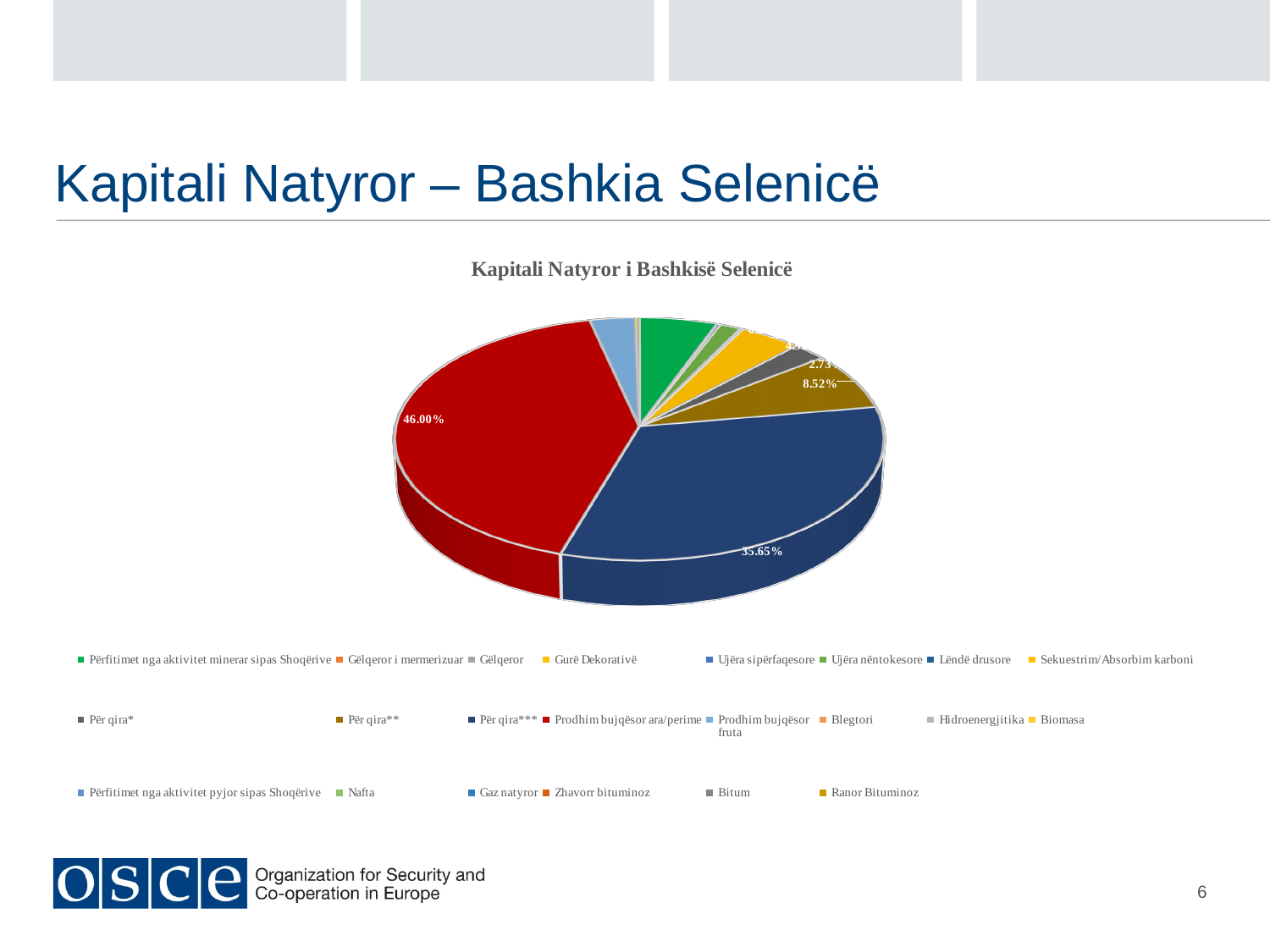
Is the share of the largest slice greater or less than 50%? less Which slice is larger: the red slice or the dark blue slice? the red slice (46.00%) How many entries does the legend list? 22 What is the combined share of the two largest slices (46.00% and 35.65%)? 81.65% What is the title of the chart? Kapitali Natyror i Bashkisë Selenicë What colour is the largest slice of the pie chart? red What kind of chart is shown on the slide? pie chart What is the share of the largest slice in the pie chart? 46.00% What share is shown for the dark gold slice on the right side of the pie? 8.52% What is the share of the second-largest slice in the pie chart? 35.65% What is the difference in percentage points between the two largest slices (46.00% and 35.65%)? 10.35 percentage points